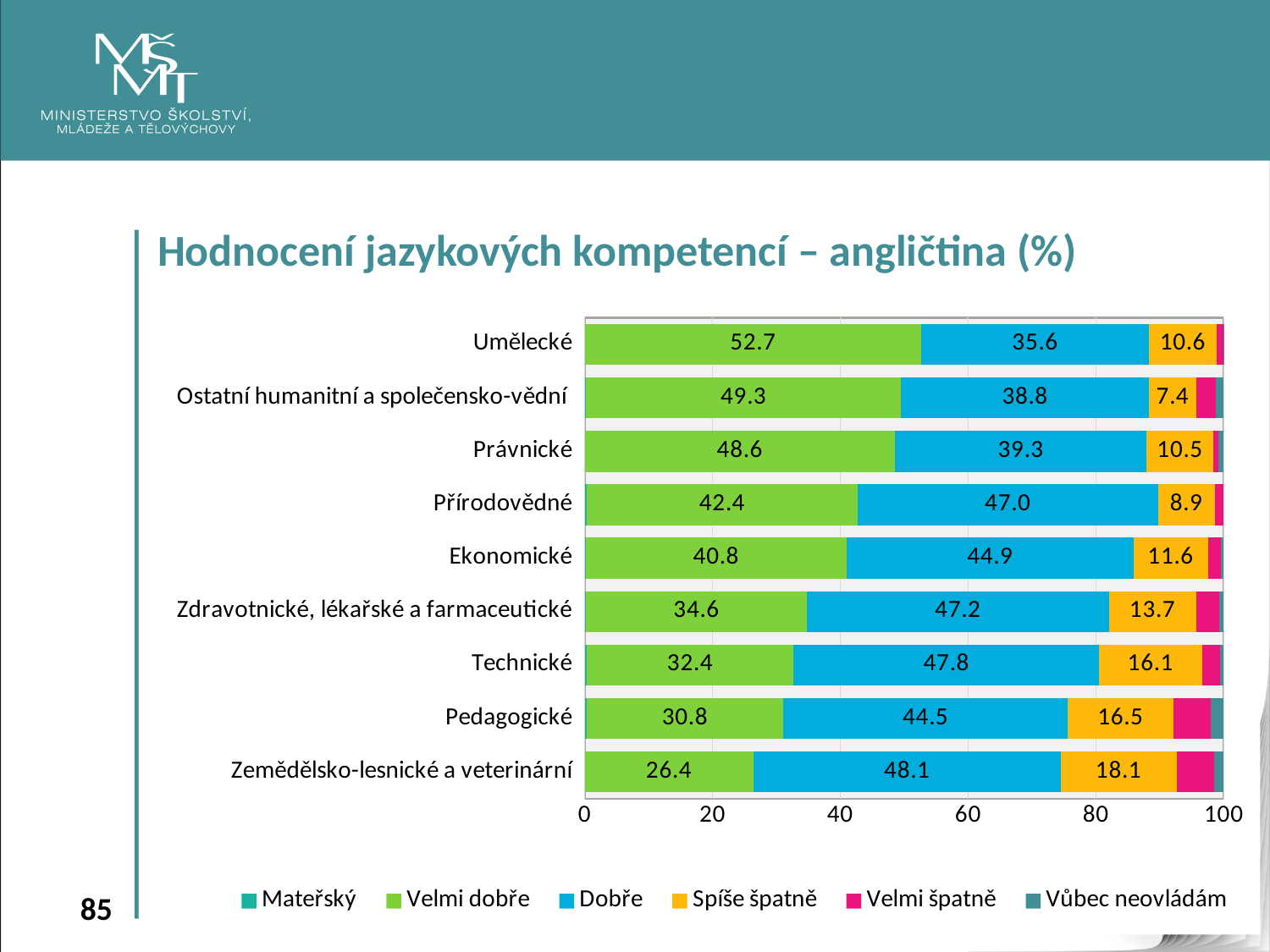
What is the title of the chart? Hodnocení jazykových kompetencí – angličtina (%) What is the "Spíše špatně" value for Zemědělsko-lesnické a veterinární? 18.1 How many categories are shown on the chart? 9 Which category has the highest "Velmi dobře" value? Umělecké Which is larger: the "Dobře" value for Přírodovědné or for Ekonomické? Přírodovědné What is the "Dobře" value for Technické? 47.8 Do the "Velmi dobře" values rise or fall going from the top category to the bottom category? Fall How many series does the legend list? 6 Which category has the lowest "Spíše špatně" value? Ostatní humanitní a společensko-vědní What is the "Velmi dobře" value for Umělecké? 52.7 What kind of chart is shown on the slide? Stacked bar chart What is the difference between the "Velmi dobře" values for Umělecké and Zemědělsko-lesnické a veterinární? 26.3